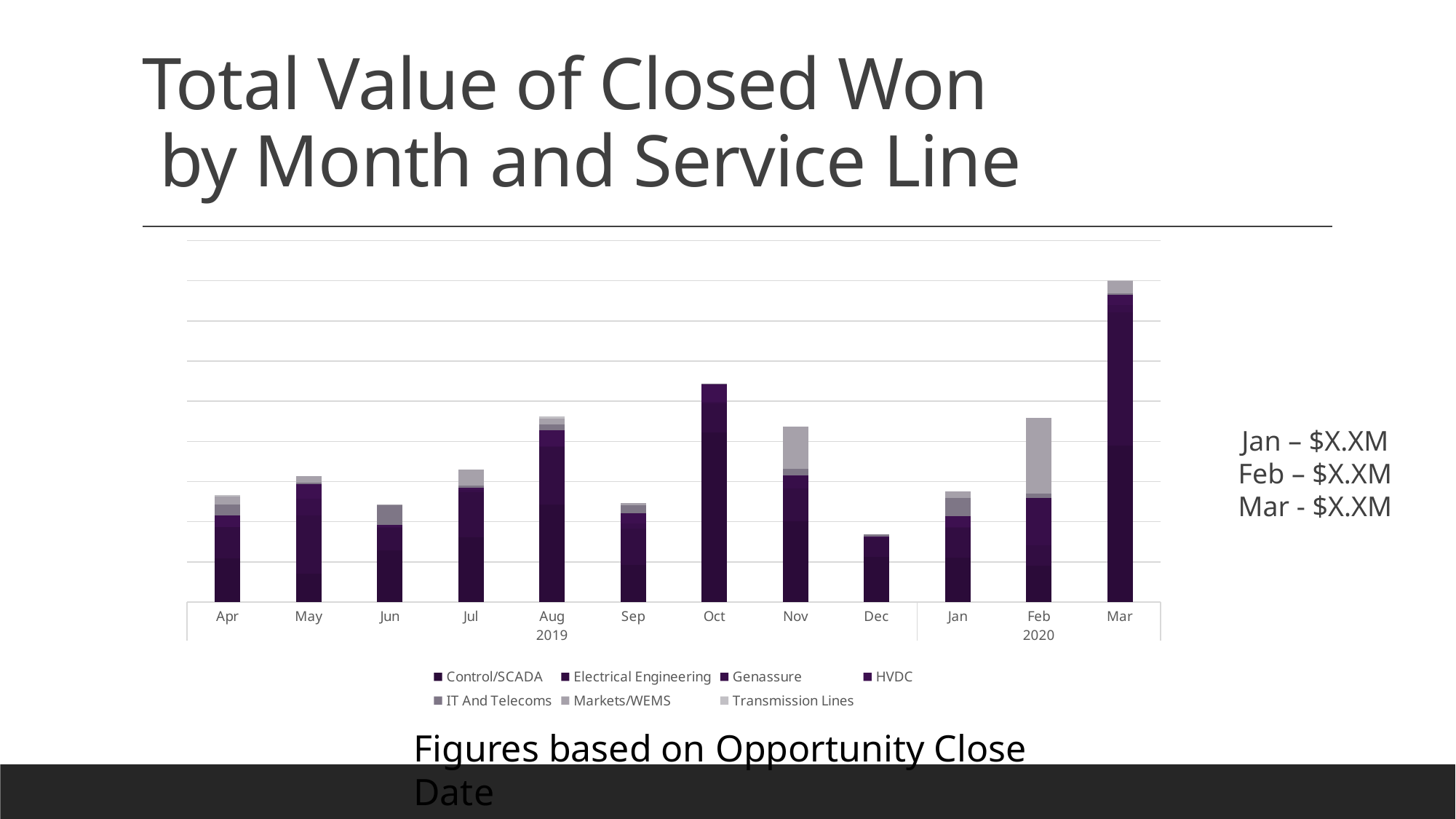
What kind of chart is shown on the slide? Stacked bar chart Which month has the lowest total value of closed won? Dec How many service lines does the legend list? 7 What is the title of the slide containing the chart? Total Value of Closed Won by Month and Service Line Which month has the highest total value of closed won? Mar Which two years are labelled on the x axis? 2019 and 2020 Which month has the larger total bar, Aug or Sep? Aug Which month has the larger total bar, Jan or Feb? Feb Which month has the larger total bar, Jun or Jul? Jul How many months are shown on the x axis? 12